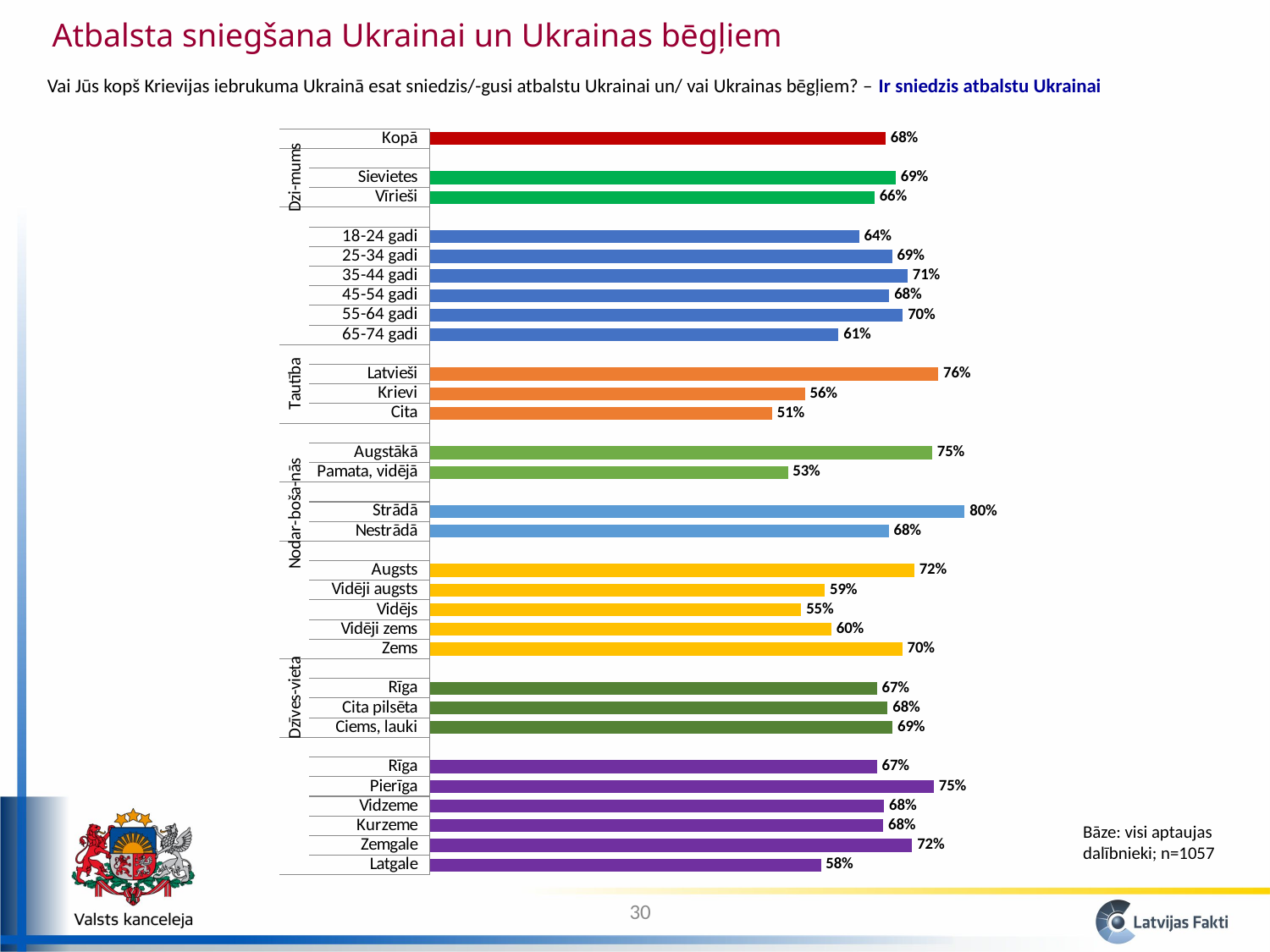
What is the difference between the values for Sievietes and Vīrieši? 3% What kind of chart is shown on the slide? Bar chart What is the value for Latvieši? 76% Which category has the highest value? Strādā What is the value for Pamata, vidējā? 53% Which is larger, the value for Augstākā or the value for Pierīga? They are equal (75%) Which is larger, the value for 35-44 gadi or the value for 65-74 gadi? 35-44 gadi How many bars are plotted in the chart? 30 Which category has the lowest value? Cita What is the value for Kopā? 68% What is the difference between the values for Latvieši and Krievi? 20% What is the value for Latgale? 58%